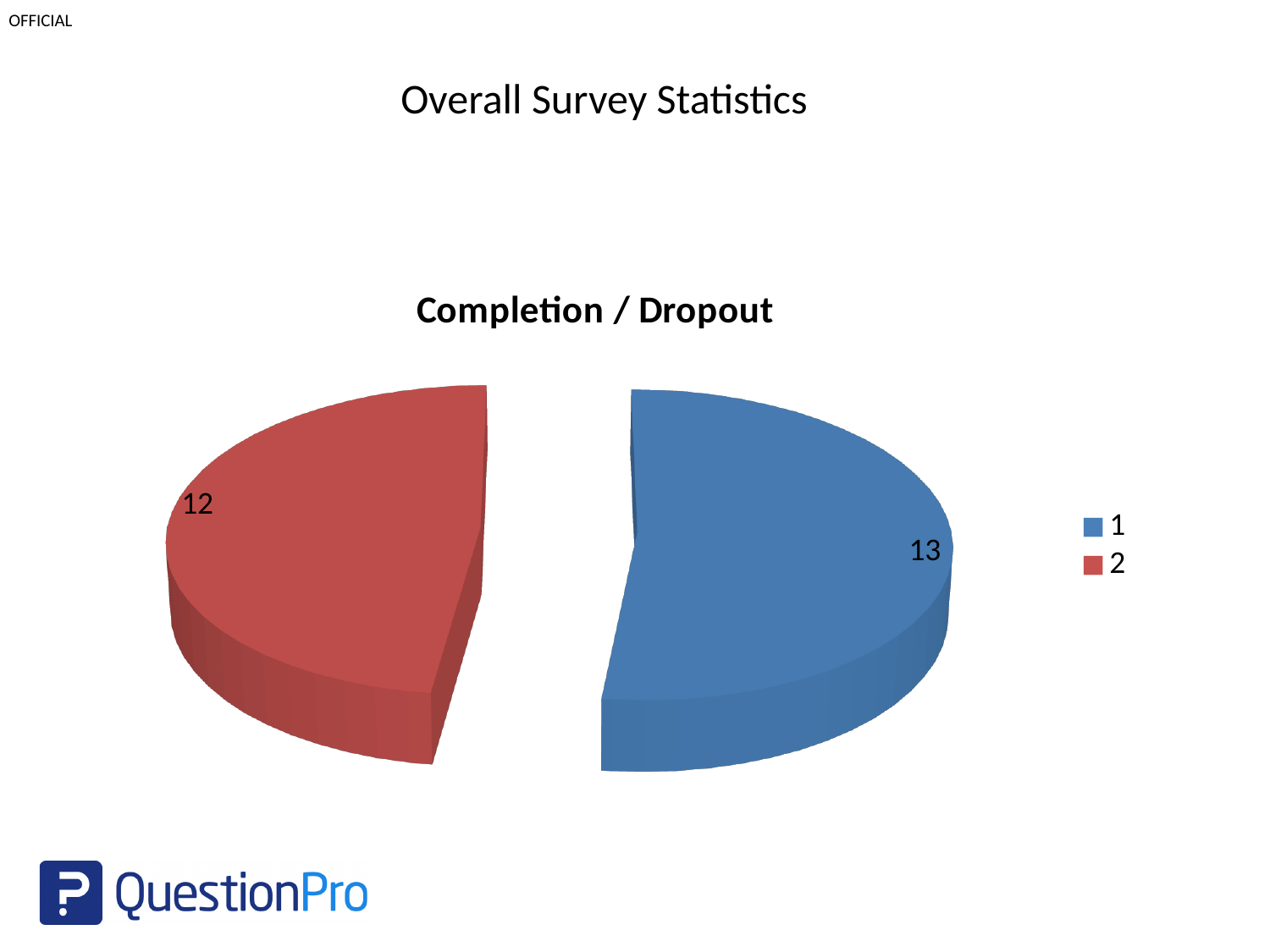
How many entries does the legend of the Completion / Dropout chart list? 2 Which category has the largest slice in the Completion / Dropout pie chart? 1 What is the title of the chart on the slide? Completion / Dropout What is the value for category 1 in the Completion / Dropout pie chart? 13 What is the value for category 2 in the Completion / Dropout pie chart? 12 What kind of chart is shown on the slide? Pie chart Which is larger in the Completion / Dropout chart, the value for category 1 or category 2? 1 What colour is the slice for category 2 in the Completion / Dropout chart? Red How many slices does the Completion / Dropout pie chart have? 2 Which category has the smallest slice in the Completion / Dropout pie chart? 2 What is the difference between the values for category 1 and category 2 in the Completion / Dropout chart? 1 What is the total of the two slices in the Completion / Dropout pie chart? 25